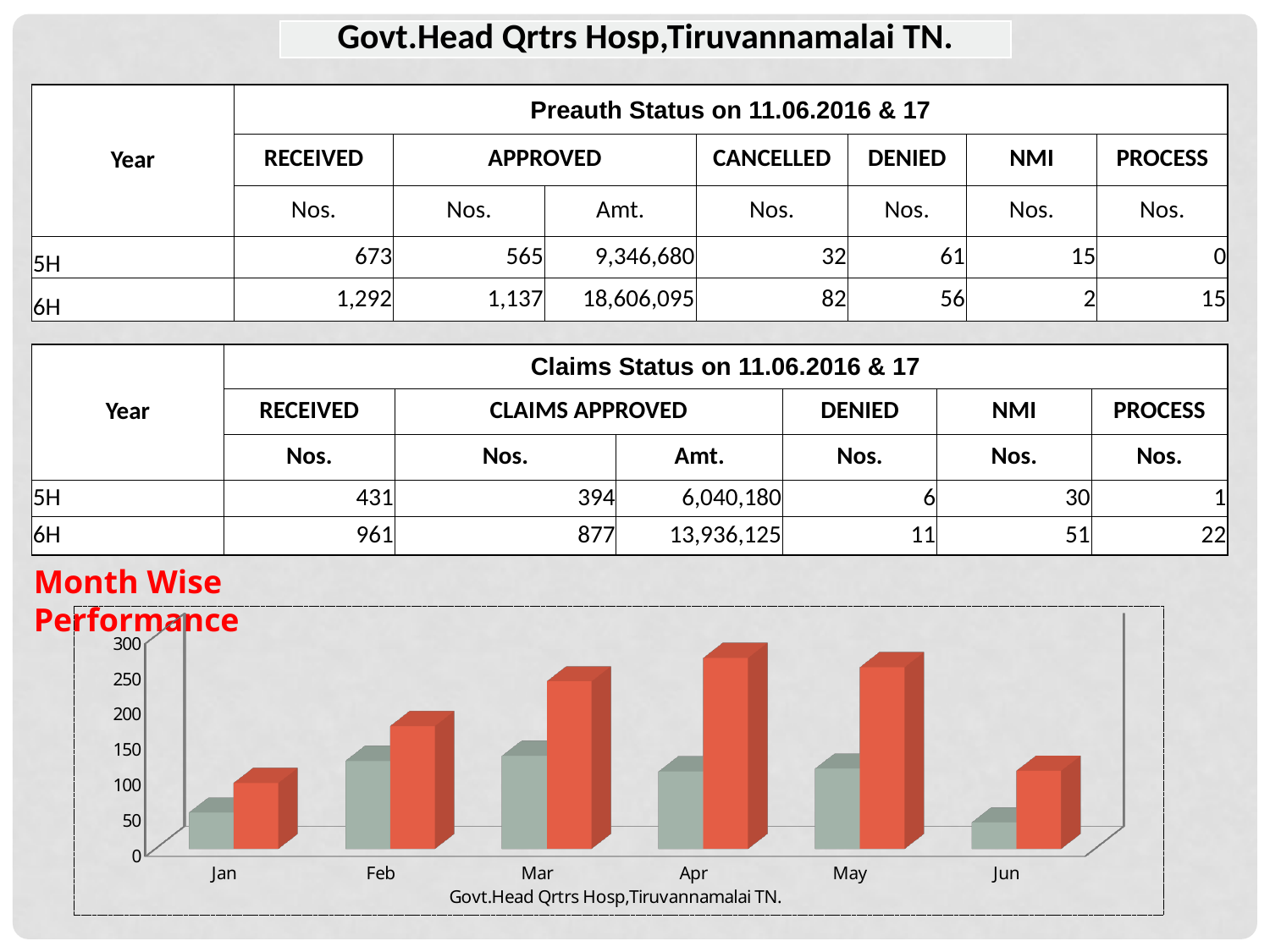
In the bar chart, do the red bars rise or fall from Jan to Apr? rise In the bar chart, is the grey bar for Mar greater or less than 100? greater How many bars are plotted for each month in the bar chart? 2 What kind of chart is shown under the heading "Month Wise Performance"? bar chart In the bar chart, is the red bar for Apr greater or less than 200? greater How many months are shown on the x axis of the bar chart? 6 In the bar chart, which month has the tallest red bar? Apr In the bar chart, which month has the shortest red bar? Jan In the bar chart, which is larger: the red bar for Mar or the red bar for Feb? Mar In the bar chart, is the red bar for Jan greater or less than 150? less What title is printed beneath the x axis of the bar chart? Govt.Head Qrtrs Hosp,Tiruvannamalai TN.